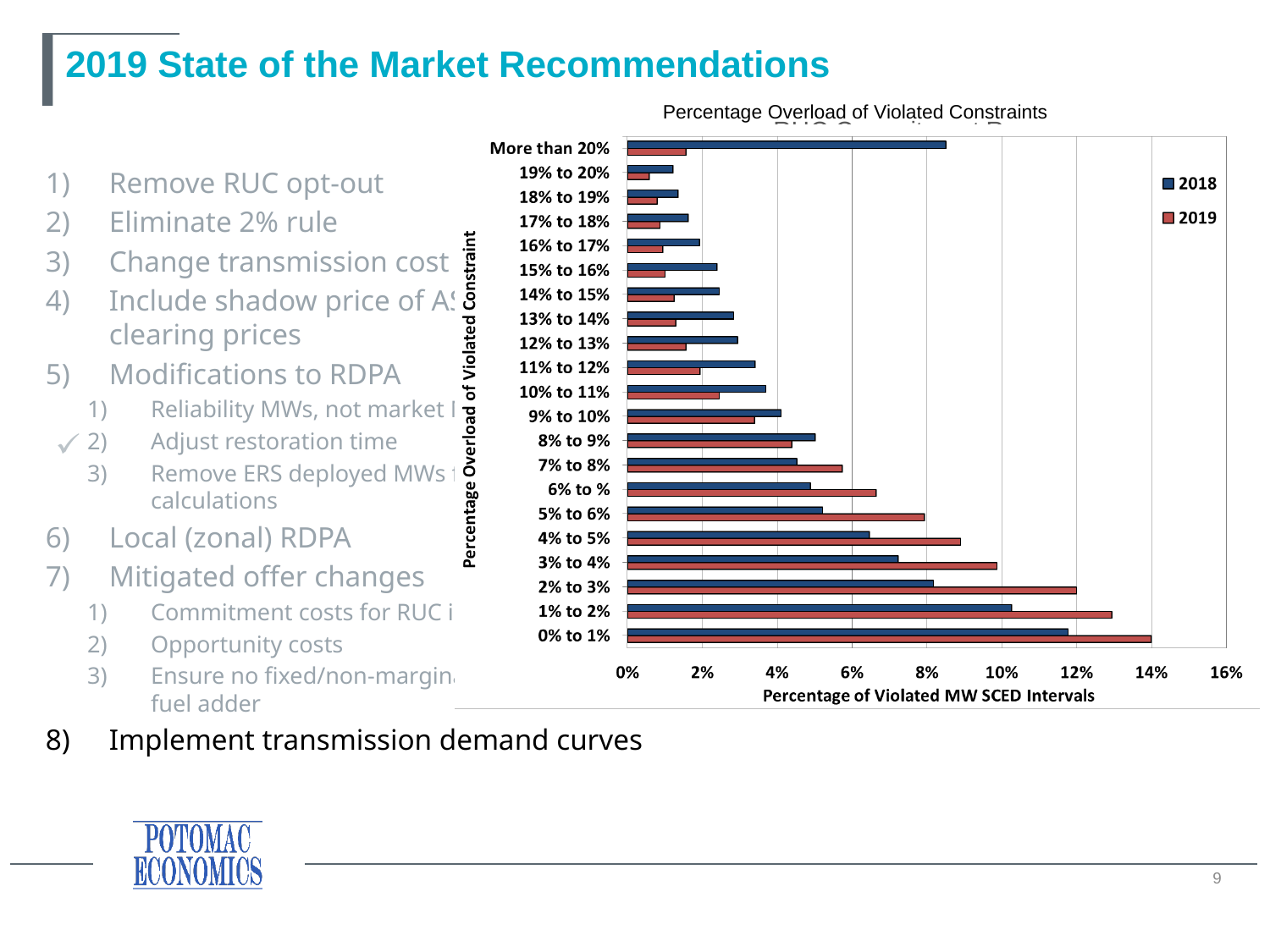
Is the 2019 value for 1% to 2% greater or less than 12%? greater What kind of chart is shown on the slide? Bar chart Which overload category has the highest 2019 value? 0% to 1% Which overload category has the highest 2018 value? 0% to 1% Is the 2019 value for More than 20% greater or less than 2%? less What is the title of the horizontal axis of the chart? Percentage of Violated MW SCED Intervals How many series does the legend of the chart list? 2 How many overload categories are plotted on the chart? 21 Is the 2018 value for 2% to 3% greater or less than 6%? greater For the 0% to 1% category, which series has the larger value, 2018 or 2019? 2019 For the More than 20% category, which series has the larger value, 2018 or 2019? 2018 For the 9% to 10% category, which series has the larger value, 2018 or 2019? 2018